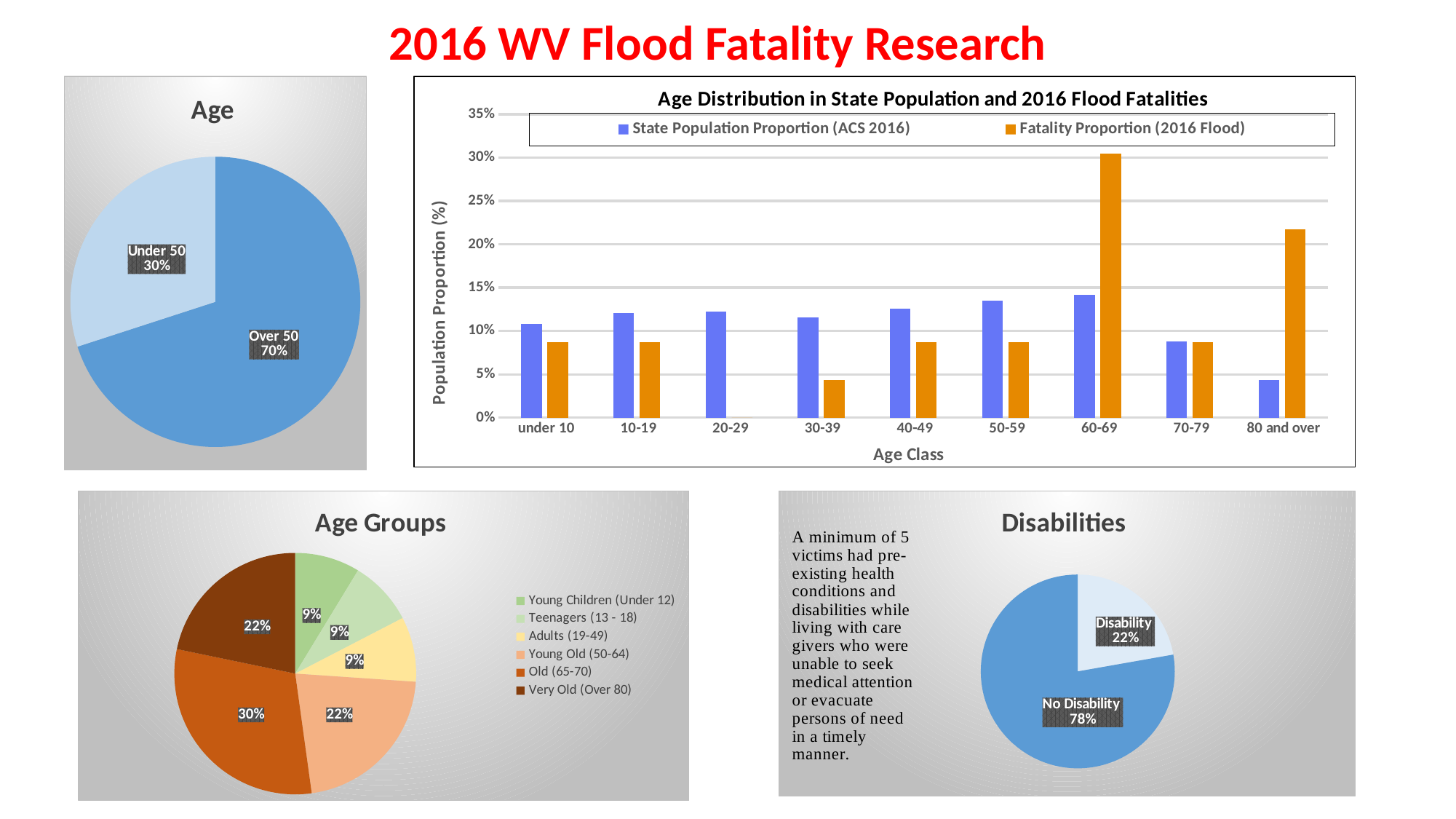
In the Age pie chart, what share of the pie is labelled Over 50? 70% In the Age Distribution in State Population and 2016 Flood Fatalities chart, which age class has the lowest State Population Proportion (ACS 2016)? 80 and over In the Age Distribution in State Population and 2016 Flood Fatalities chart, which age class has the highest Fatality Proportion (2016 Flood)? 60-69 In the Disabilities pie chart, what is the difference between the No Disability and Disability percentages? 56% In the Age Distribution in State Population and 2016 Flood Fatalities chart, is the Fatality Proportion (2016 Flood) for 30-39 greater or less than 5%? less In the Age pie chart, what is the difference between the Over 50 and Under 50 percentages? 40% In the Age Distribution in State Population and 2016 Flood Fatalities chart, how many age classes are shown on the x axis? 9 In the Age Groups pie chart, how many age groups does the legend list? 6 In the Age Distribution in State Population and 2016 Flood Fatalities chart, is the Fatality Proportion (2016 Flood) for 60-69 greater or less than 25%? greater In the Age Groups pie chart, which age group has the largest share? Old (65-70) In the Age Distribution in State Population and 2016 Flood Fatalities chart, what kind of chart is shown? bar chart In the Age Distribution in State Population and 2016 Flood Fatalities chart, how many series does the legend list? 2